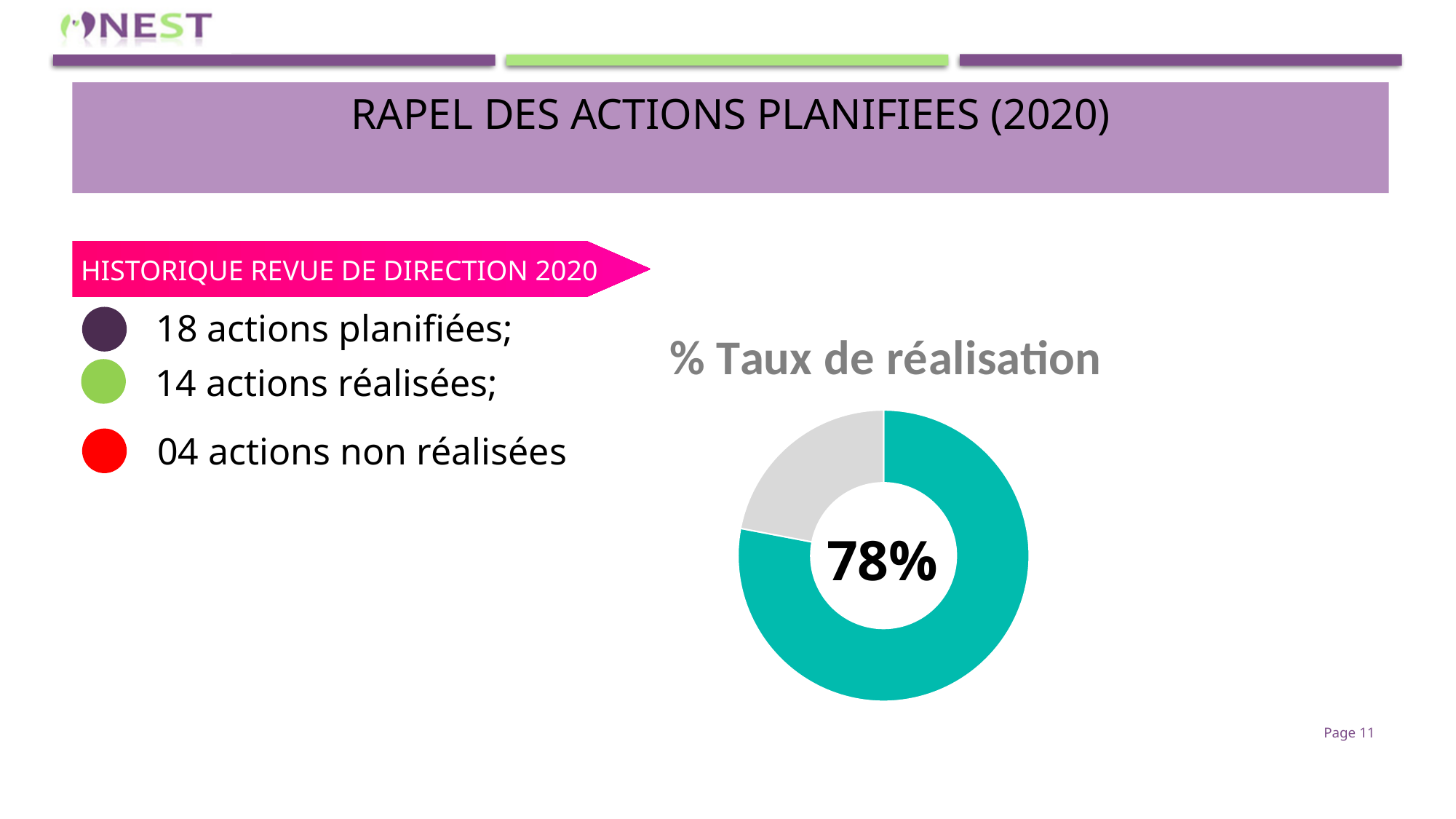
Does the teal slice of the doughnut chart cover more or less than half of the ring? More What is the title of the chart on the slide? % Taux de réalisation Which slice of the doughnut chart is larger, the teal one or the grey one? The teal one What colour is the slice of the doughnut chart that represents the 78% realisation rate? Teal What percentage is printed in the centre of the doughnut chart? 78% What kind of chart is shown on the slide? Doughnut chart How many slices does the doughnut chart have? 2